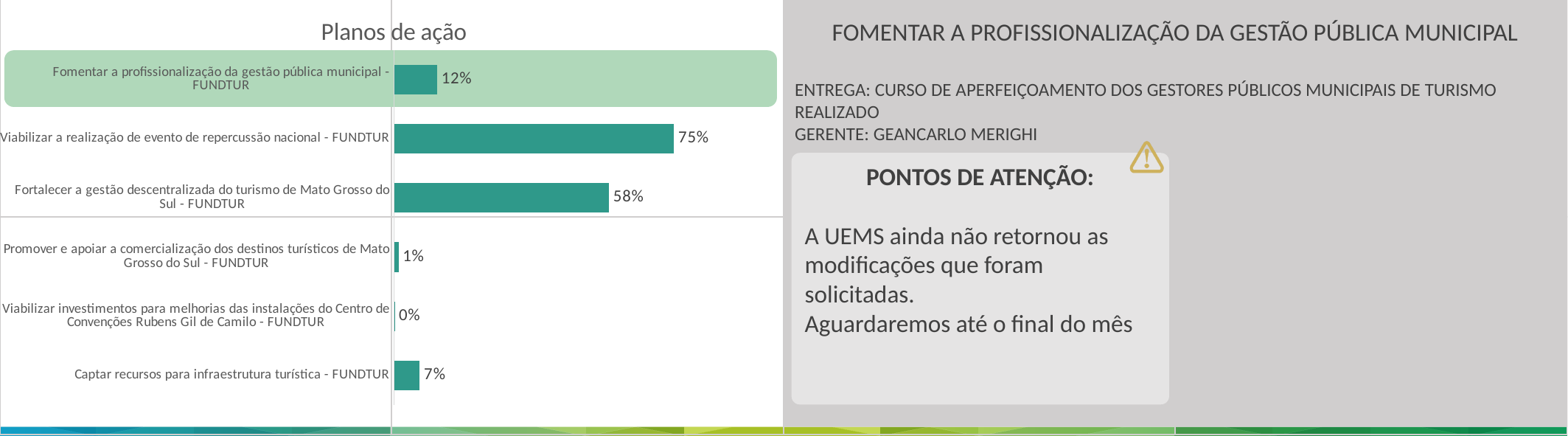
How many categories are shown in the chart? 6 Which category has the highest value? Viabilizar a realização de evento de repercussão nacional - FUNDTUR Which is larger: the value for "Fomentar a profissionalização da gestão pública municipal - FUNDTUR" or for "Captar recursos para infraestrutura turística - FUNDTUR"? Fomentar a profissionalização da gestão pública municipal - FUNDTUR What is the difference between the values for "Viabilizar a realização de evento de repercussão nacional - FUNDTUR" and "Fortalecer a gestão descentralizada do turismo de Mato Grosso do Sul - FUNDTUR"? 17% What is the value for "Viabilizar a realização de evento de repercussão nacional - FUNDTUR"? 75% What is the value for "Fomentar a profissionalização da gestão pública municipal - FUNDTUR"? 12% What is the value for "Promover e apoiar a comercialização dos destinos turísticos de Mato Grosso do Sul - FUNDTUR"? 1% What kind of chart is shown on the slide? Bar chart What is the title of the chart? Planos de ação Which category has the lowest value? Viabilizar investimentos para melhorias das instalações do Centro de Convenções Rubens Gil de Camilo - FUNDTUR What is the value for "Viabilizar investimentos para melhorias das instalações do Centro de Convenções Rubens Gil de Camilo - FUNDTUR"? 0% What is the value for "Captar recursos para infraestrutura turística - FUNDTUR"? 7%